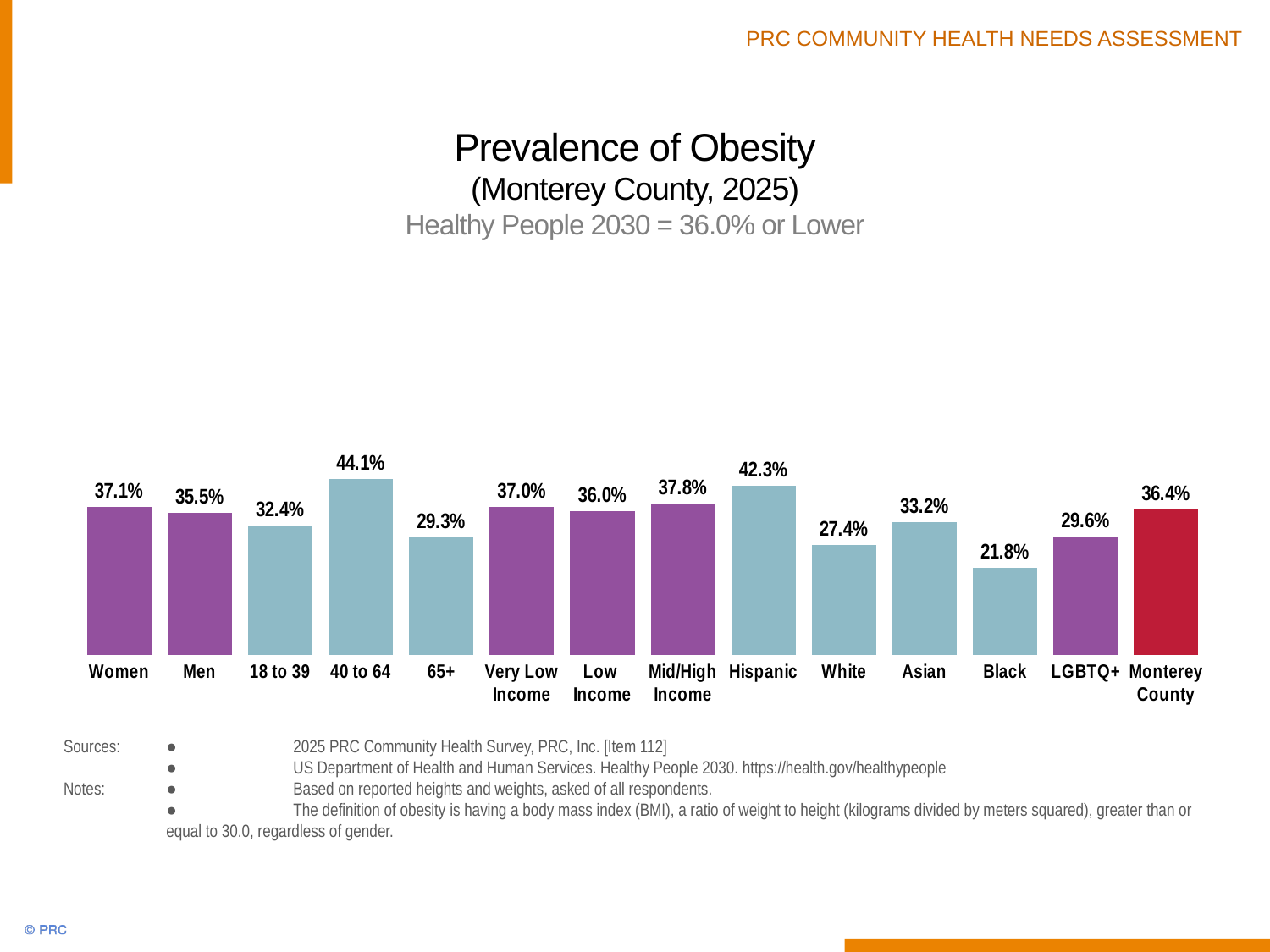
What is the difference in obesity prevalence between Women and Men? 1.6% What is the prevalence of obesity for the 65+ age group? 29.3% Which has a higher prevalence of obesity, Very Low Income or Mid/High Income? Mid/High Income What is the prevalence of obesity for Hispanic respondents? 42.3% What is the difference in obesity prevalence between Hispanic and White respondents? 14.9% How many categories are shown in the chart? 14 What is the prevalence of obesity for Women? 37.1% Which category has the lowest prevalence of obesity? Black What is the prevalence of obesity for Monterey County overall? 36.4% What kind of chart is shown on the slide? Bar chart What is the Healthy People 2030 target stated in the chart subtitle? 36.0% or Lower Which category has the highest prevalence of obesity? 40 to 64